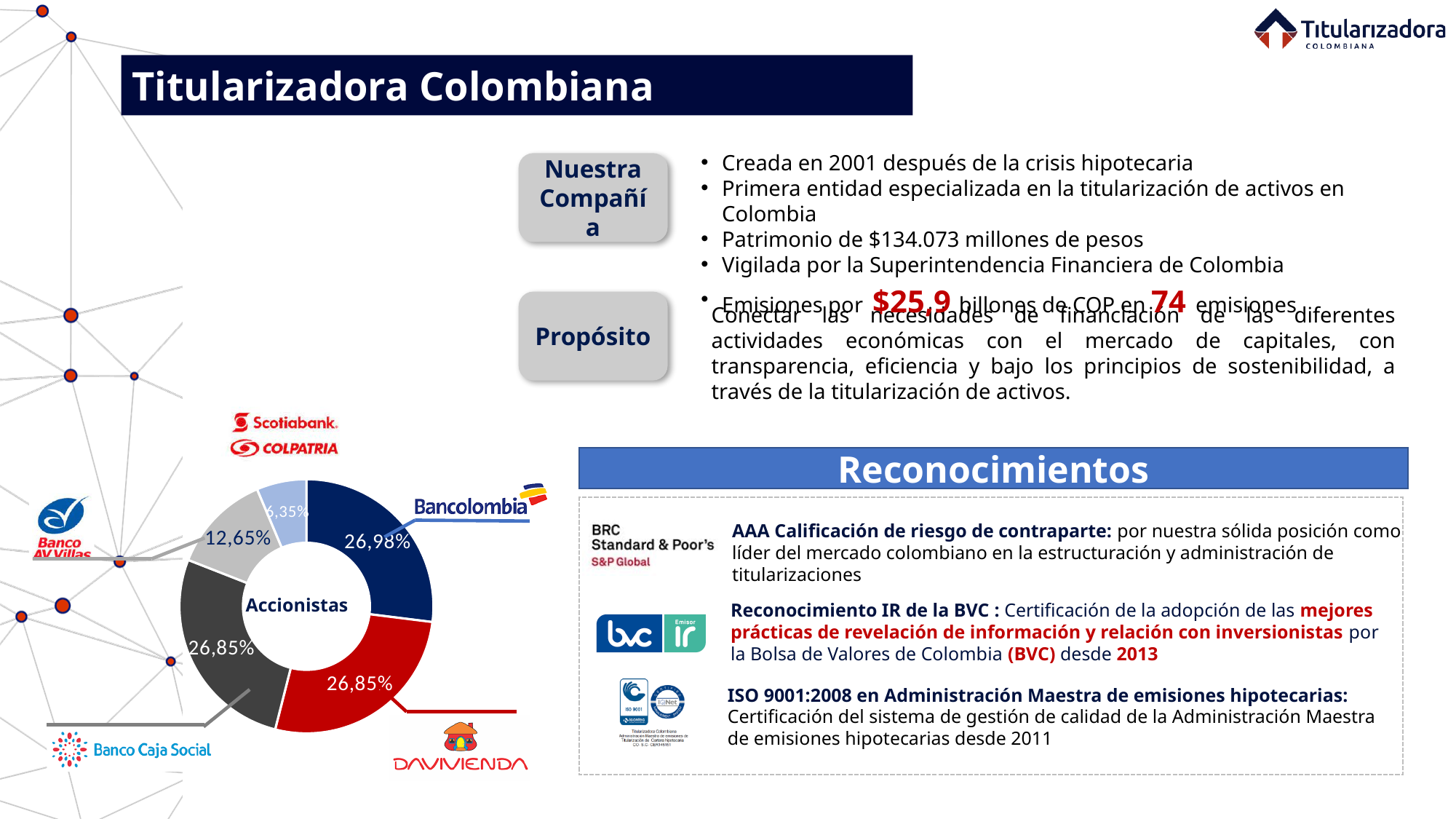
In the Accionistas chart, what share does Bancolombia hold? 26,98% How many shareholders are shown in the Accionistas chart? 5 What kind of chart is used to show the Accionistas breakdown? Pie (donut) chart In the Accionistas chart, which is larger: the share of Banco AV Villas or the share of Scotiabank Colpatria? Banco AV Villas Which shareholder has the largest share in the Accionistas chart? Bancolombia In the Accionistas chart, what share does Scotiabank Colpatria hold? 6,35% In the Accionistas chart, what share does Davivienda hold? 26,85% What is the title shown in the centre of the donut chart? Accionistas In the Accionistas chart, what is the difference between Bancolombia's share and Banco AV Villas' share? 14,33% In the Accionistas chart, what is the difference between Banco AV Villas' share and Scotiabank Colpatria's share? 6,30% In the Accionistas chart, what share does Banco AV Villas hold? 12,65% Which shareholder has the smallest share in the Accionistas chart? Scotiabank Colpatria